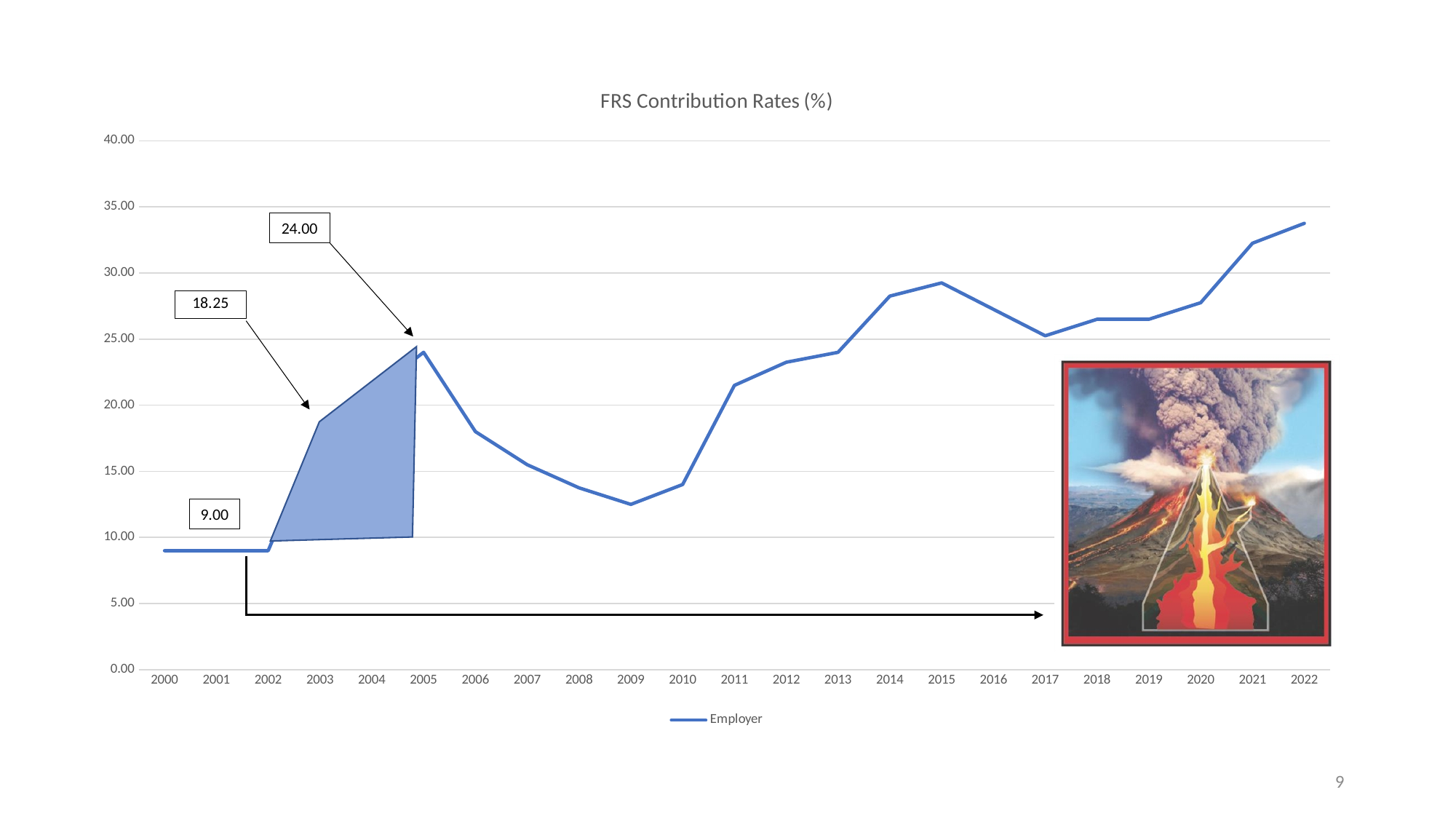
What is the title of the chart? FRS Contribution Rates (%) Which year has the larger Employer contribution rate, 2014 or 2017? 2014 Does the Employer contribution rate rise or fall from 2005 to 2009? fall What is the difference between the labelled values for 2005 and 2003? 5.75 What is the Employer contribution rate labelled for 2005? 24.00 How many series does the legend list? 1 What is the Employer contribution rate labelled for 2003? 18.25 How many years are plotted along the x axis? 23 Is the Employer contribution rate for 2009 greater or less than 15.00? less What is the Employer contribution rate labelled for 2000? 9.00 What type of chart is shown on the slide? line chart Which year has the highest Employer contribution rate? 2022